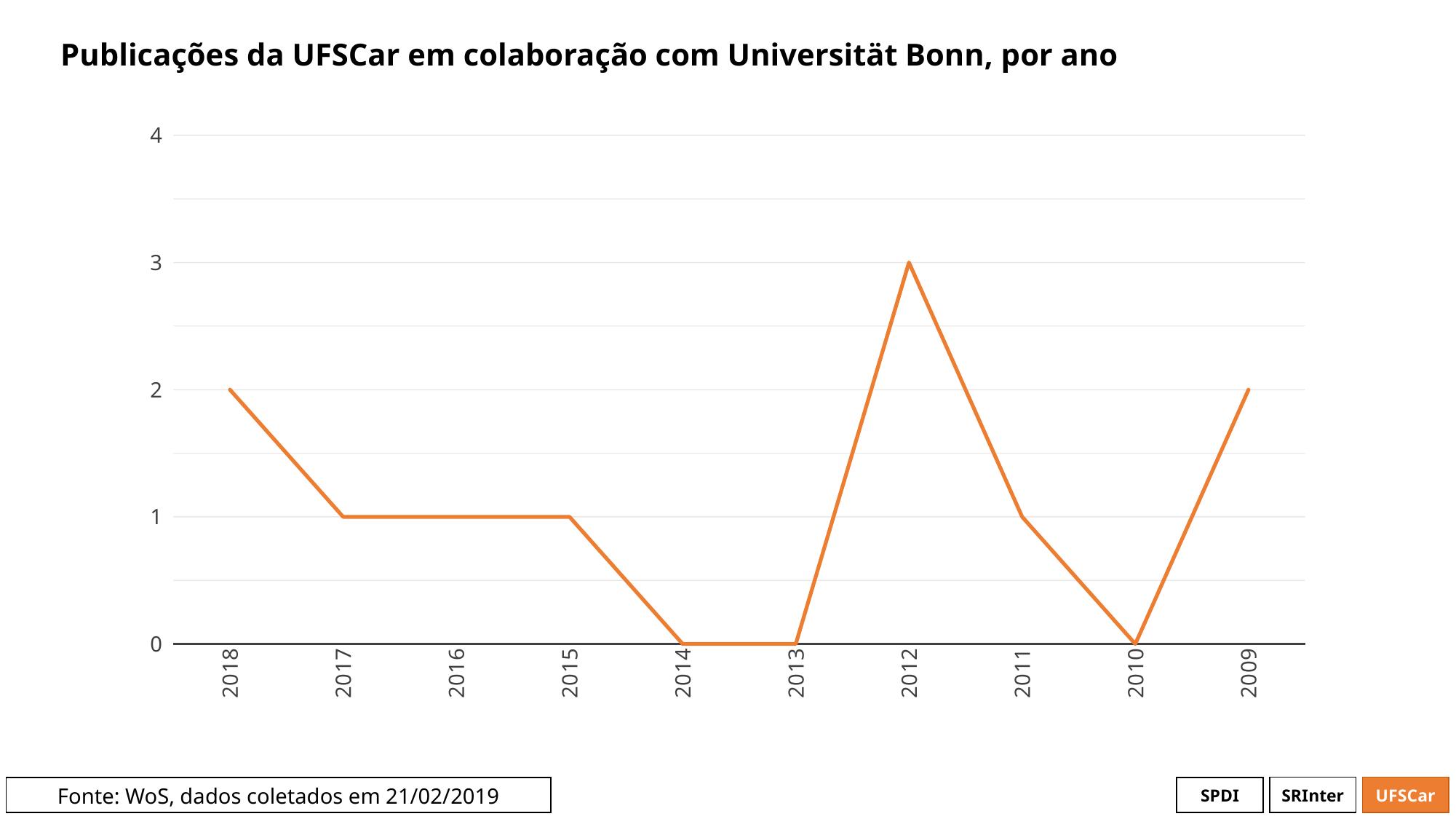
What is the number of publications for 2018? 2 What is the difference between the values for 2012 and 2011? 2 How many years are plotted on the chart? 10 Which is larger, the value for 2018 or the value for 2017? 2018 Do the values rise or fall along the x axis from 2018 to 2015? fall What is the number of publications for 2014? 0 What is the number of publications for 2012? 3 What is the number of publications for 2011? 1 What is the title of the chart? Publicações da UFSCar em colaboração com Universität Bonn, por ano What is the number of publications for 2009? 2 What type of chart is shown on the slide? line chart Which year has the highest number of publications? 2012